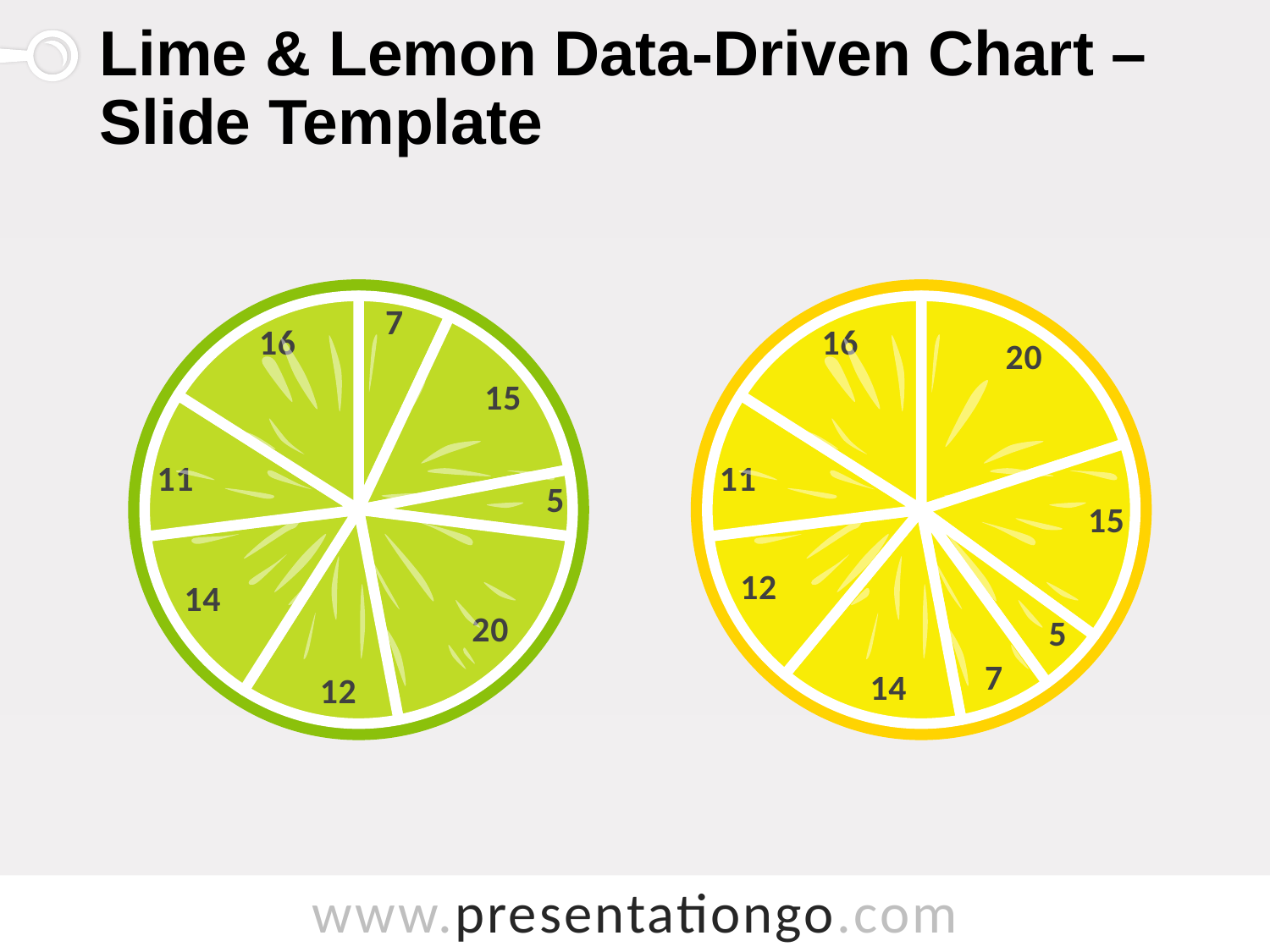
How many slices does the left (green lime) pie chart have? 8 In the right (yellow lemon) pie chart, what is the largest slice value? 20 In the right (yellow lemon) pie chart, what share of the total does the slice labelled 20 represent? 20% In the left (green lime) pie chart, what is the largest slice value? 20 What is the sum of all slice values in the right (yellow lemon) pie chart? 100 How many slices does the right (yellow lemon) pie chart have? 8 In the left (green lime) pie chart, what is the smallest slice value? 5 In the left (green lime) pie chart, what is the difference between the largest slice (20) and the smallest slice (5)? 15 In the right (yellow lemon) pie chart, what is the smallest slice value? 5 What kind of chart is the left (green lime) chart? pie chart What is the sum of all slice values in the left (green lime) pie chart? 100 What colour is the right pie chart on the slide? yellow